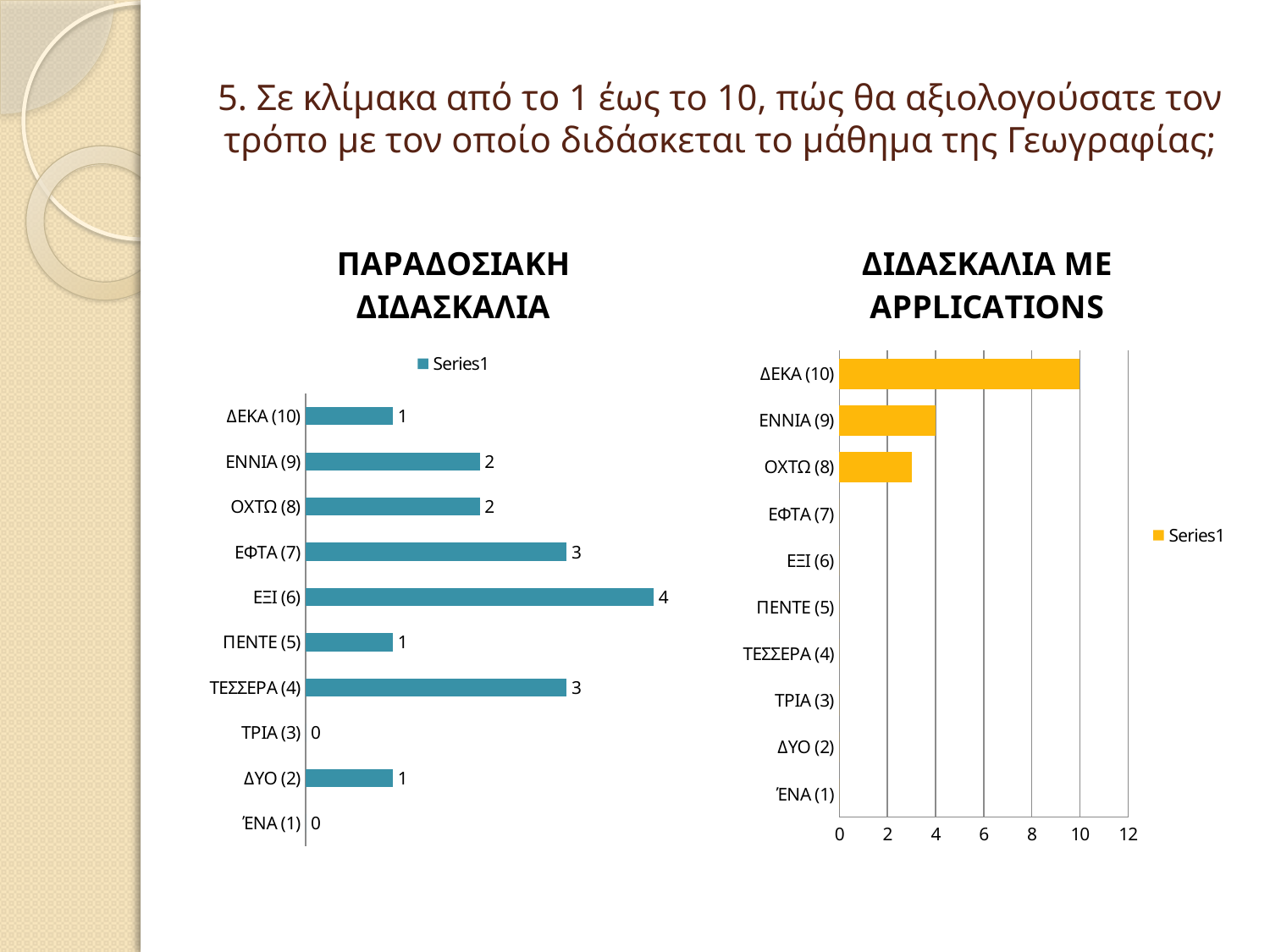
How many series does the legend of the ΔΙΔΑΣΚΑΛΙΑ ΜΕ APPLICATIONS chart list? 1 In the ΠΑΡΑΔΟΣΙΑΚΗ ΔΙΔΑΣΚΑΛΙΑ chart, what is the difference between the values for ΕΞΙ (6) and ΔΕΚΑ (10)? 3 In the ΔΙΔΑΣΚΑΛΙΑ ΜΕ APPLICATIONS chart, is the value for ΟΧΤΩ (8) greater or less than 2? greater In the ΔΙΔΑΣΚΑΛΙΑ ΜΕ APPLICATIONS chart, what is the value for ΔΕΚΑ (10)? 10 How many categories are shown in the ΠΑΡΑΔΟΣΙΑΚΗ ΔΙΔΑΣΚΑΛΙΑ chart? 10 In the ΠΑΡΑΔΟΣΙΑΚΗ ΔΙΔΑΣΚΑΛΙΑ chart, which is larger, the value for ΕΦΤΑ (7) or the value for ΕΝΝΙΑ (9)? ΕΦΤΑ (7) What kind of chart is the ΔΙΔΑΣΚΑΛΙΑ ΜΕ APPLICATIONS chart? Bar chart In the ΠΑΡΑΔΟΣΙΑΚΗ ΔΙΔΑΣΚΑΛΙΑ chart, what is the value for ΕΞΙ (6)? 4 In the ΠΑΡΑΔΟΣΙΑΚΗ ΔΙΔΑΣΚΑΛΙΑ chart, what is the value for ΤΕΣΣΕΡΑ (4)? 3 In the ΔΙΔΑΣΚΑΛΙΑ ΜΕ APPLICATIONS chart, which is larger, the value for ΕΝΝΙΑ (9) or the value for ΟΧΤΩ (8)? ΕΝΝΙΑ (9) In the ΠΑΡΑΔΟΣΙΑΚΗ ΔΙΔΑΣΚΑΛΙΑ chart, which category has the highest value? ΕΞΙ (6) In the ΔΙΔΑΣΚΑΛΙΑ ΜΕ APPLICATIONS chart, which category has the highest value? ΔΕΚΑ (10)